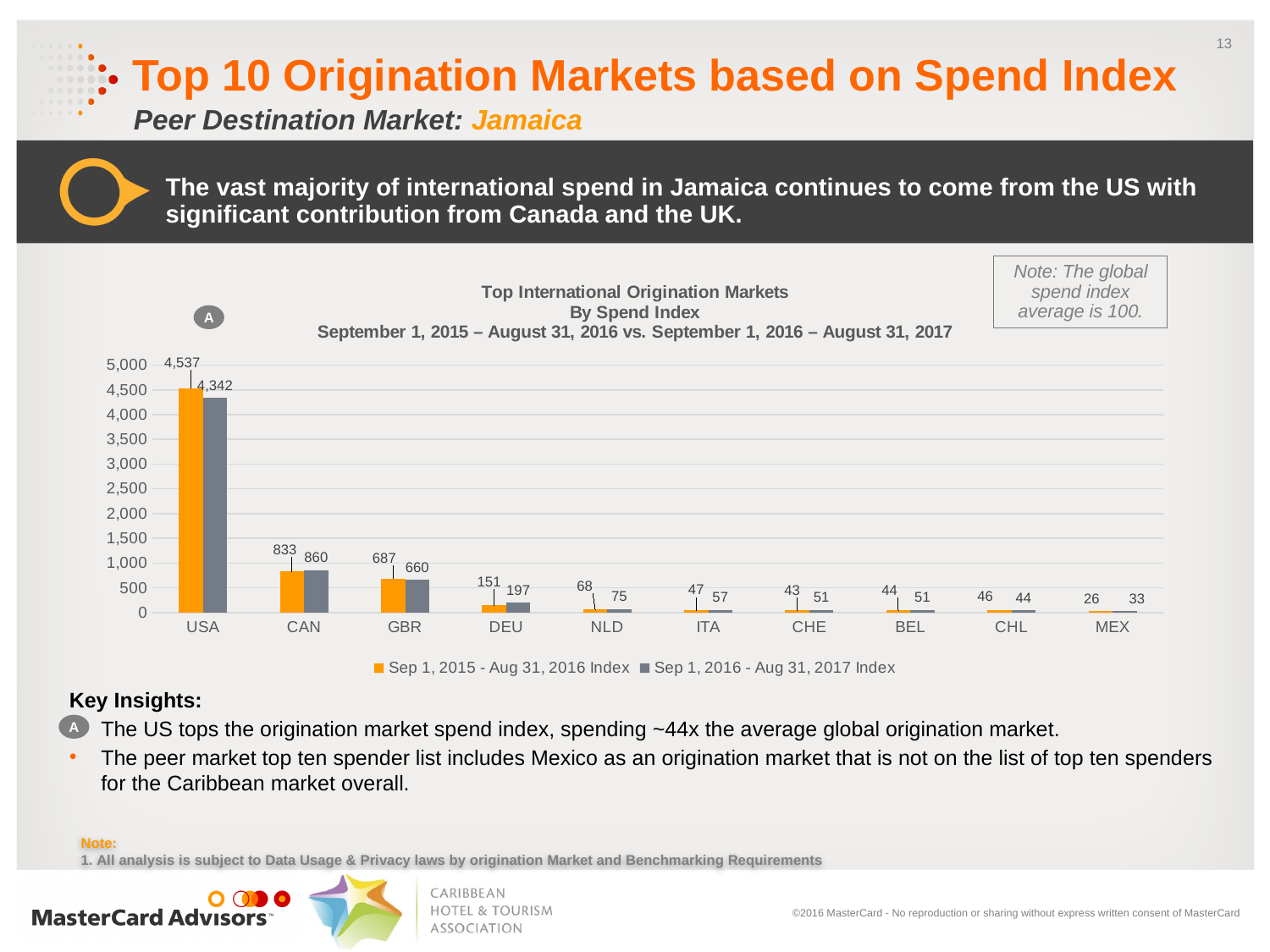
What kind of chart is shown on the slide? Bar chart What is the difference between the USA's Sep 1, 2015 - Aug 31, 2016 Index and its Sep 1, 2016 - Aug 31, 2017 Index? 195 What is the Sep 1, 2015 - Aug 31, 2016 Index value for USA? 4,537 What is the Sep 1, 2016 - Aug 31, 2017 Index value for CAN? 860 Which is larger for GBR: the Sep 1, 2015 - Aug 31, 2016 Index or the Sep 1, 2016 - Aug 31, 2017 Index? Sep 1, 2015 - Aug 31, 2016 Index What is the global spend index average stated in the note on the slide? 100 What is the Sep 1, 2016 - Aug 31, 2017 Index value for DEU? 197 Which origination market has the highest Sep 1, 2016 - Aug 31, 2017 Index value? USA Is the Sep 1, 2016 - Aug 31, 2017 Index value for CAN greater or less than 500? greater How many series does the chart legend list? 2 Which origination market has the lowest Sep 1, 2015 - Aug 31, 2016 Index value? MEX How many origination markets are shown on the x axis of the chart? 10